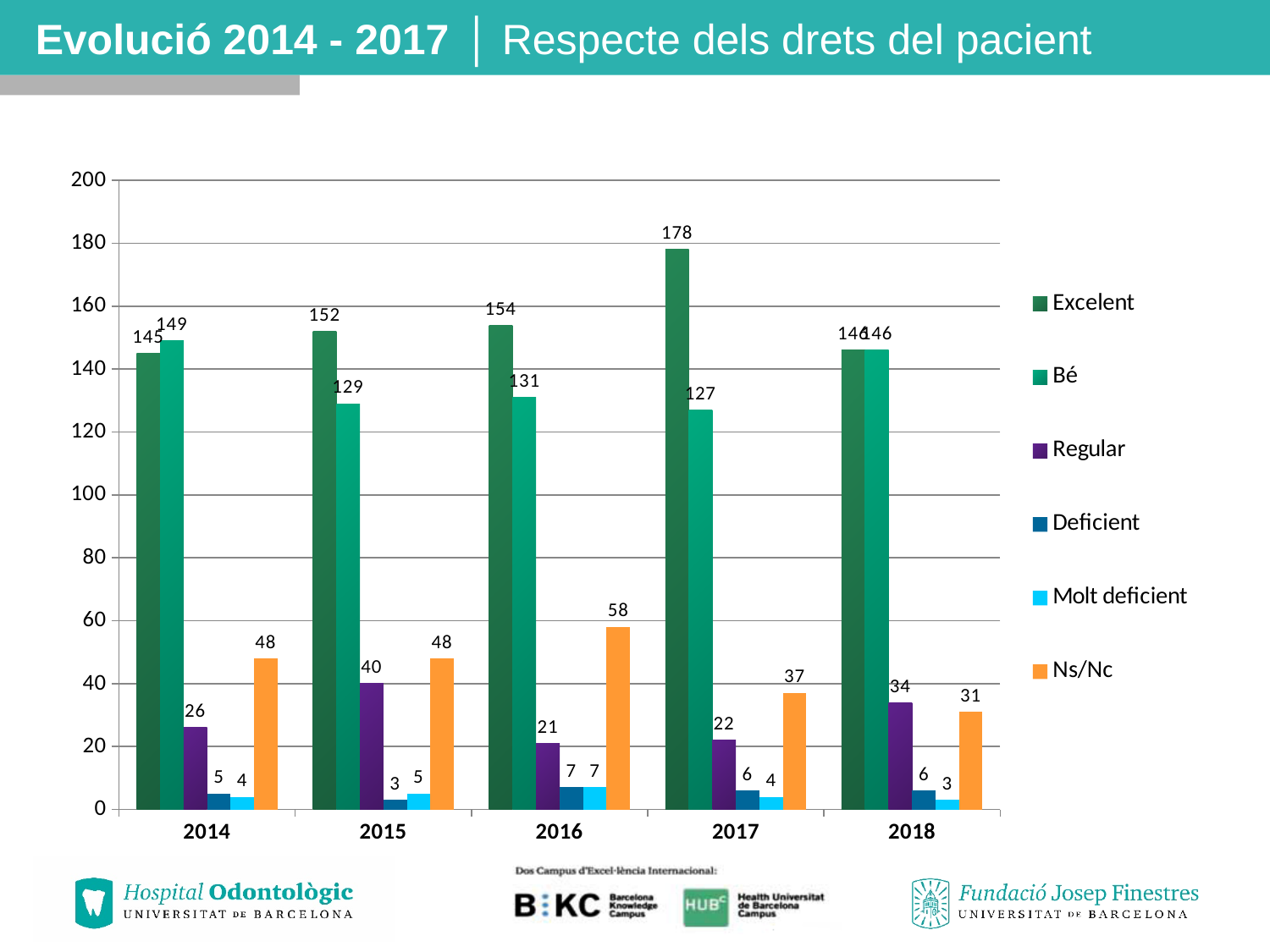
What is the value for Ns/Nc in 2016? 58 What is the value for Excelent in 2017? 178 What colour represents Ns/Nc in the legend? orange What is the difference between the Excelent and Bé values in 2017? 51 In 2014, which is larger: Excelent or Bé? Bé In which year is the Excelent value highest? 2017 How many series does the legend list? 6 In which year is the Ns/Nc value lowest? 2018 What is the value for Regular in 2015? 40 What kind of chart is shown on the slide? bar chart How many years are shown on the x axis? 5 Does the Excelent value rise or fall from 2014 to 2017? rise